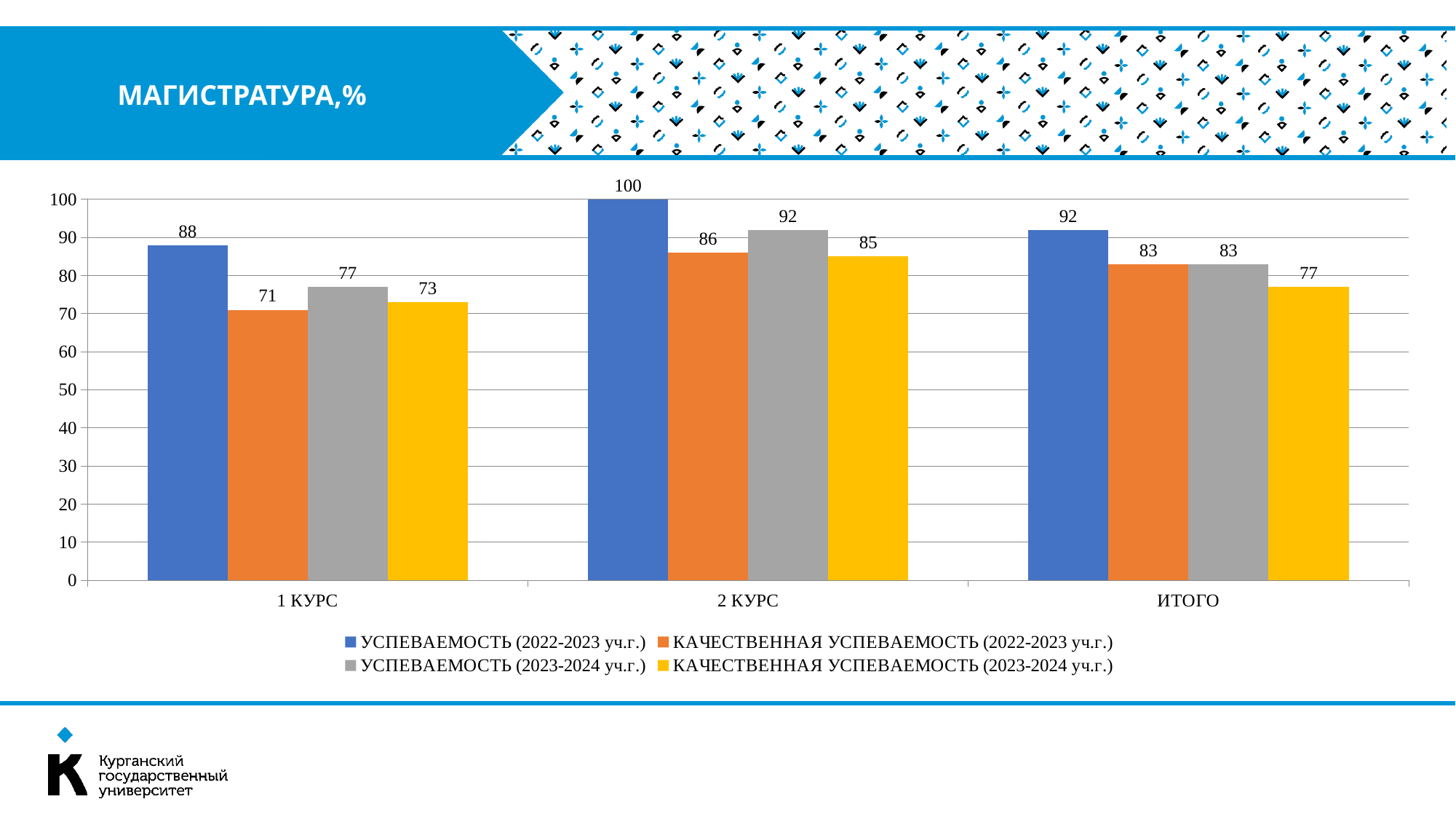
What is the value of КАЧЕСТВЕННАЯ УСПЕВАЕМОСТЬ (2023-2024 уч.г.) for 2 КУРС? 85 What kind of chart is shown on the slide? bar chart Which category has the lowest value for КАЧЕСТВЕННАЯ УСПЕВАЕМОСТЬ (2022-2023 уч.г.)? 1 КУРС What is the difference between УСПЕВАЕМОСТЬ (2022-2023 уч.г.) and УСПЕВАЕМОСТЬ (2023-2024 уч.г.) for 1 КУРС? 11 How many categories are shown on the x axis? 3 Is the value of КАЧЕСТВЕННАЯ УСПЕВАЕМОСТЬ (2023-2024 уч.г.) for 1 КУРС greater or less than 80? less Which category has the highest value for УСПЕВАЕМОСТЬ (2022-2023 уч.г.)? 2 КУРС Which is larger for 2 КУРС: УСПЕВАЕМОСТЬ (2022-2023 уч.г.) or УСПЕВАЕМОСТЬ (2023-2024 уч.г.)? УСПЕВАЕМОСТЬ (2022-2023 уч.г.) What is the title of the slide? МАГИСТРАТУРА,% How many series does the legend list? 4 What is the value of УСПЕВАЕМОСТЬ (2023-2024 уч.г.) for ИТОГО? 83 What is the value of УСПЕВАЕМОСТЬ (2022-2023 уч.г.) for 1 КУРС? 88